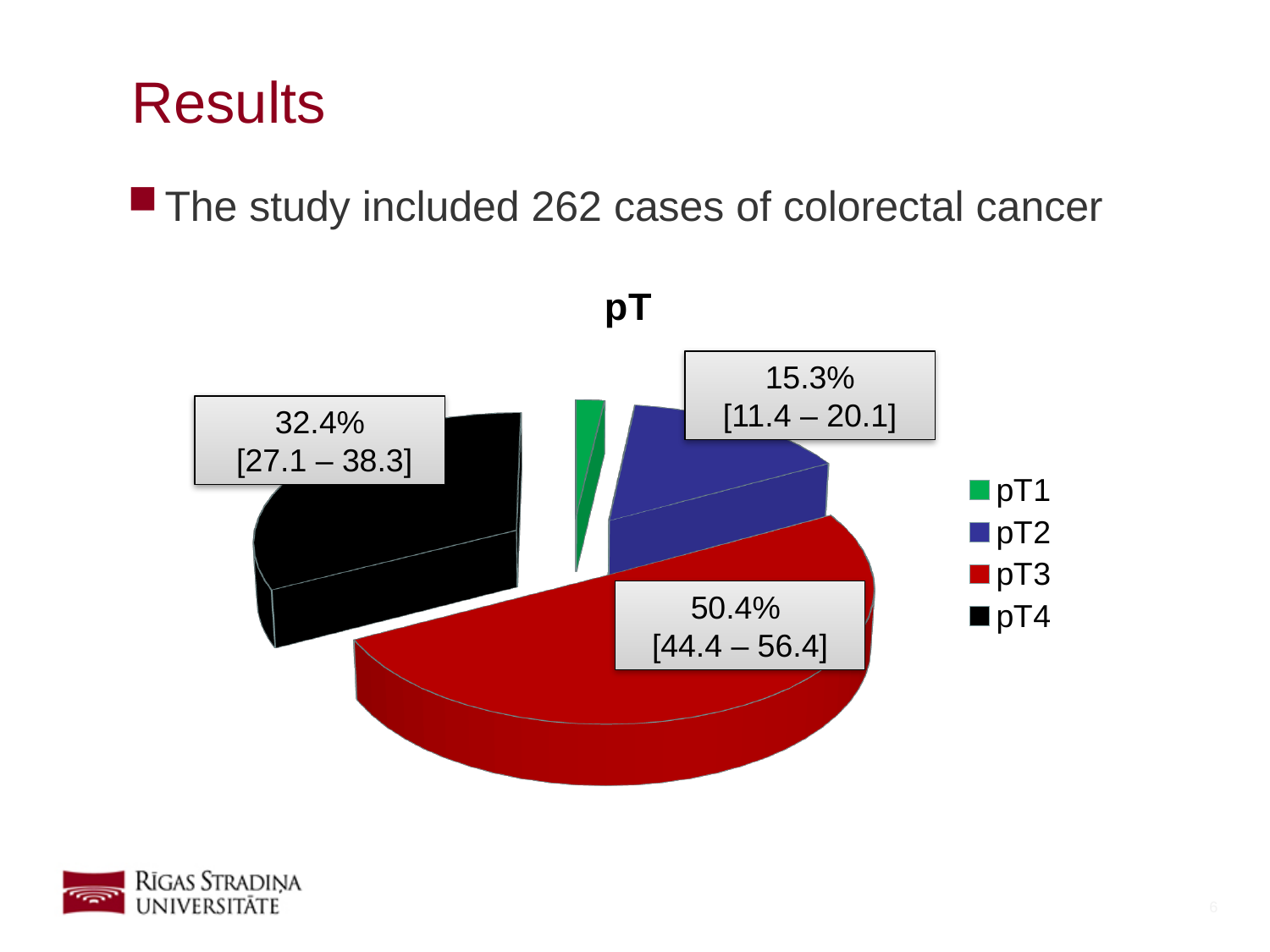
By how many percentage points does the pT3 share exceed the pT4 share? 18.0 What percentage of cases are pT3 in the pT pie chart? 50.4% What confidence interval is shown for the pT3 slice? [44.4 – 56.4] How many categories does the pT pie chart show? 4 What percentage of cases are pT4 in the pT pie chart? 32.4% Which pT category has the largest share of the pie? pT3 How many entries does the legend of the pT chart list? 4 What colour represents pT3 in the pie chart? Red What kind of chart is shown on the slide? Pie chart What percentage of cases are pT2 in the pT pie chart? 15.3% Which has a larger share, pT4 or pT2? pT4 Which pT category has the smallest share of the pie? pT1